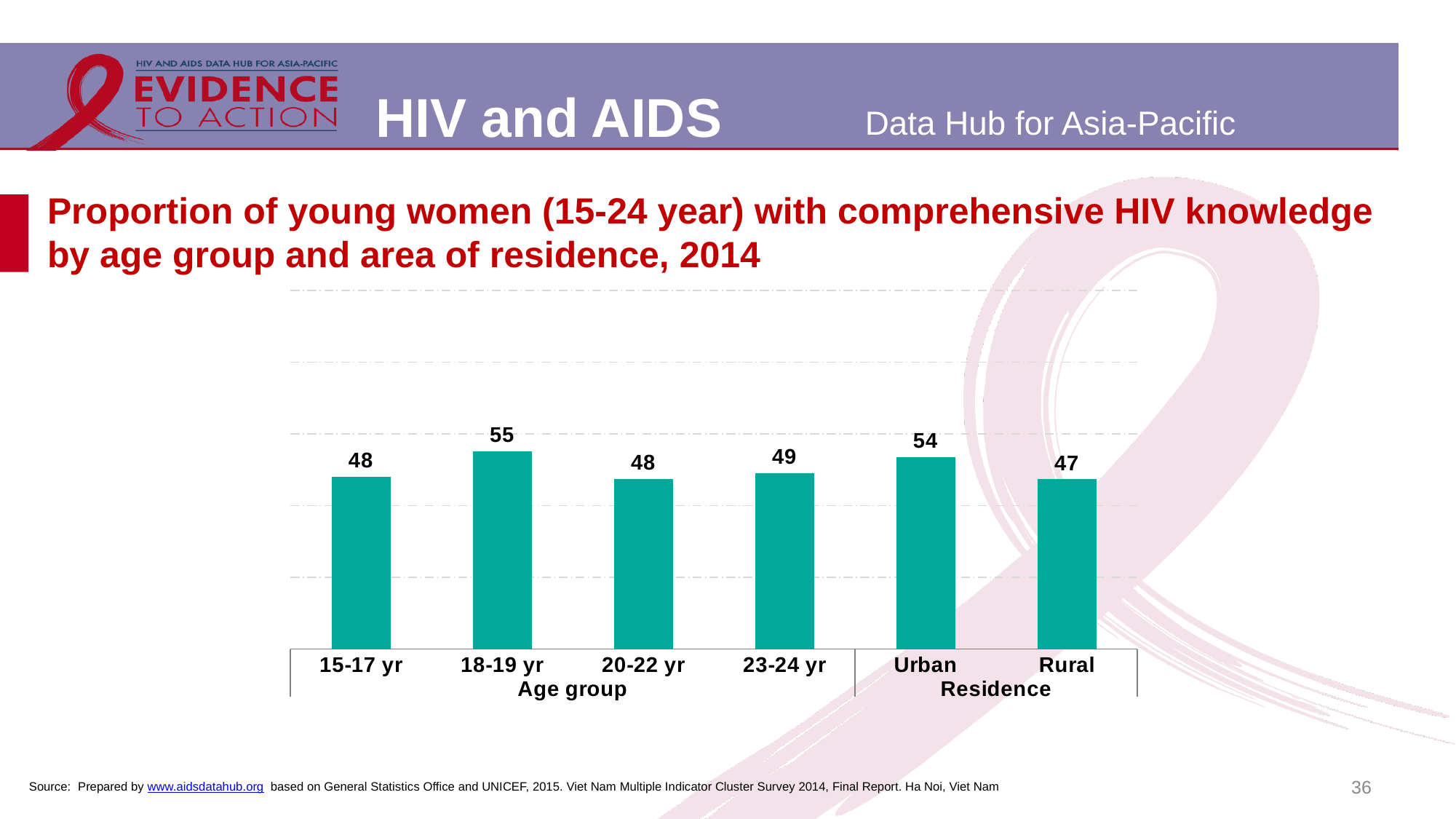
What is the value for Urban residence? 54 What is the value for Rural residence? 47 How many bars are shown in the chart? 6 What are the two group labels shown beneath the category axis? Age group and Residence What is the difference between the Urban and Rural values? 7 What is the value for the 23-24 yr age group? 49 What is the value for the 18-19 yr age group? 55 Which category has the lowest value? Rural What kind of chart is shown on the slide? Bar chart Which category has the highest value? 18-19 yr Which is larger, the value for Urban or the value for Rural? Urban What is the difference between the 18-19 yr and 15-17 yr values? 7